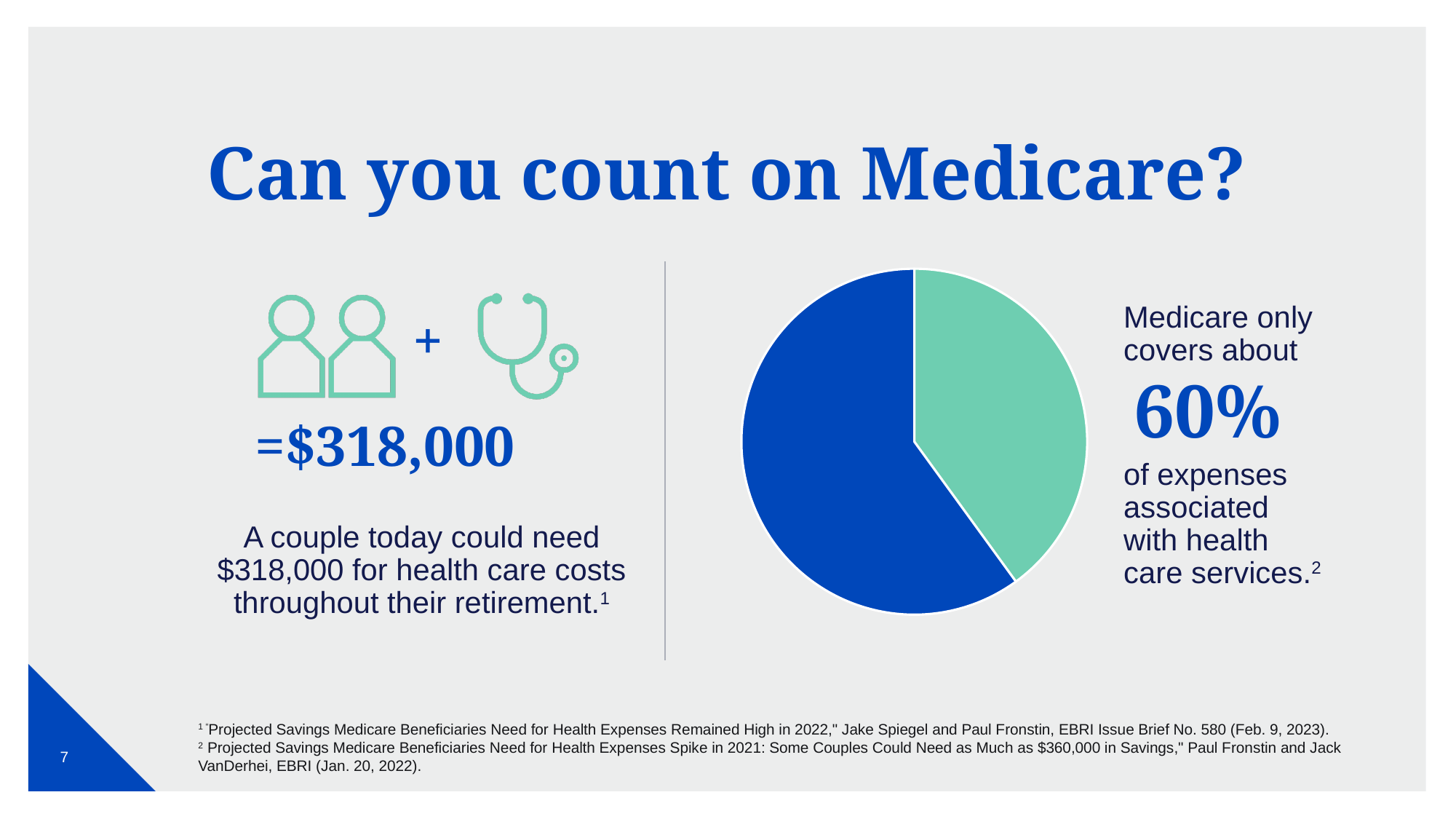
What is the title of the slide containing the pie chart? Can you count on Medicare? What two colours are used for the slices of the pie chart? dark blue and teal Which slice of the pie chart is the smallest? the teal slice Is the dark blue slice of the pie chart greater or less than half of the pie? greater According to the text next to the pie chart, about what percentage of expenses associated with health care services does Medicare cover? 60% Is the teal slice of the pie chart greater or less than half of the pie? less Which slice of the pie chart is larger, the dark blue one or the teal one? dark blue What kind of chart is shown on the slide? pie chart How many slices does the pie chart have? 2